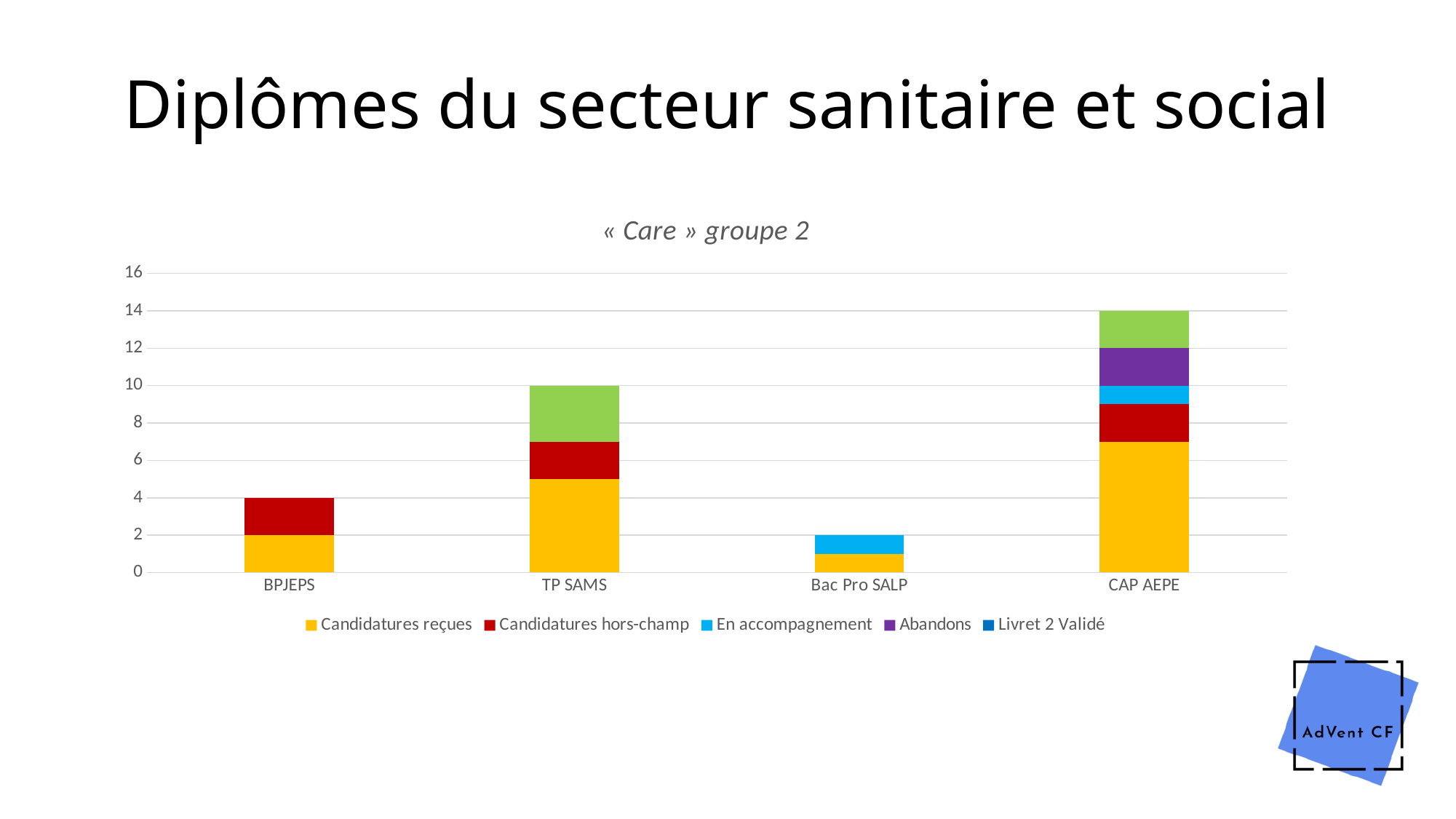
How many diploma categories are shown on the x axis? 4 What is the value of Candidatures reçues for BPJEPS? 2 What is the total height of the stacked bar for BPJEPS? 4 Which diploma has the shortest stacked bar? Bac Pro SALP Is the total for CAP AEPE greater or less than 12? greater What kind of chart is shown on the slide? Stacked bar chart What is the total height of the stacked bar for CAP AEPE? 14 How many series does the legend list? 5 Which has a larger total, TP SAMS or BPJEPS? TP SAMS What is the total height of the stacked bar for TP SAMS? 10 What is the title of the chart? « Care » groupe 2 Which diploma has the tallest stacked bar? CAP AEPE